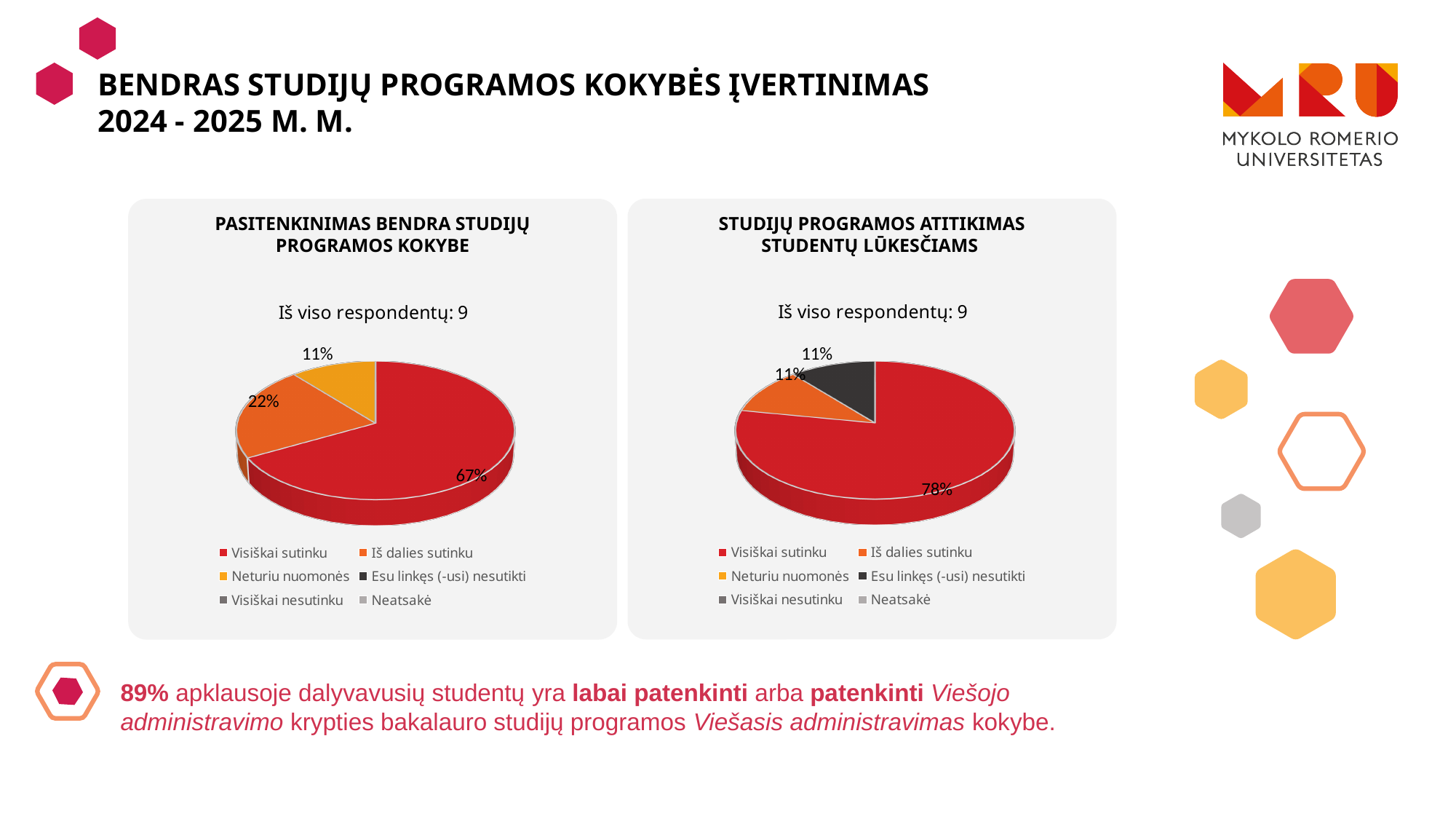
In the chart titled 'Studijų programos atitikimas studentų lūkesčiams', which category has the largest slice? Visiškai sutinku In the chart titled 'Pasitenkinimas bendra studijų programos kokybe', which category has the smallest slice? Neturiu nuomonės In the chart titled 'Studijų programos atitikimas studentų lūkesčiams', what share of respondents chose 'Esu linkęs (-usi) nesutikti'? 11% In the chart titled 'Studijų programos atitikimas studentų lūkesčiams', what share of respondents chose 'Visiškai sutinku'? 78% What type of chart is used in the chart titled 'Studijų programos atitikimas studentų lūkesčiams'? Pie chart In the chart titled 'Pasitenkinimas bendra studijų programos kokybe', which category has the largest slice? Visiškai sutinku In the chart titled 'Pasitenkinimas bendra studijų programos kokybe', what is the difference in percentage points between 'Visiškai sutinku' and 'Iš dalies sutinku'? 45 percentage points In the chart titled 'Pasitenkinimas bendra studijų programos kokybe', what share of respondents chose 'Neturiu nuomonės'? 11% How many entries does the legend list in the chart titled 'Pasitenkinimas bendra studijų programos kokybe'? 6 Which chart has the larger 'Visiškai sutinku' share: 'Pasitenkinimas bendra studijų programos kokybe' or 'Studijų programos atitikimas studentų lūkesčiams'? Studijų programos atitikimas studentų lūkesčiams